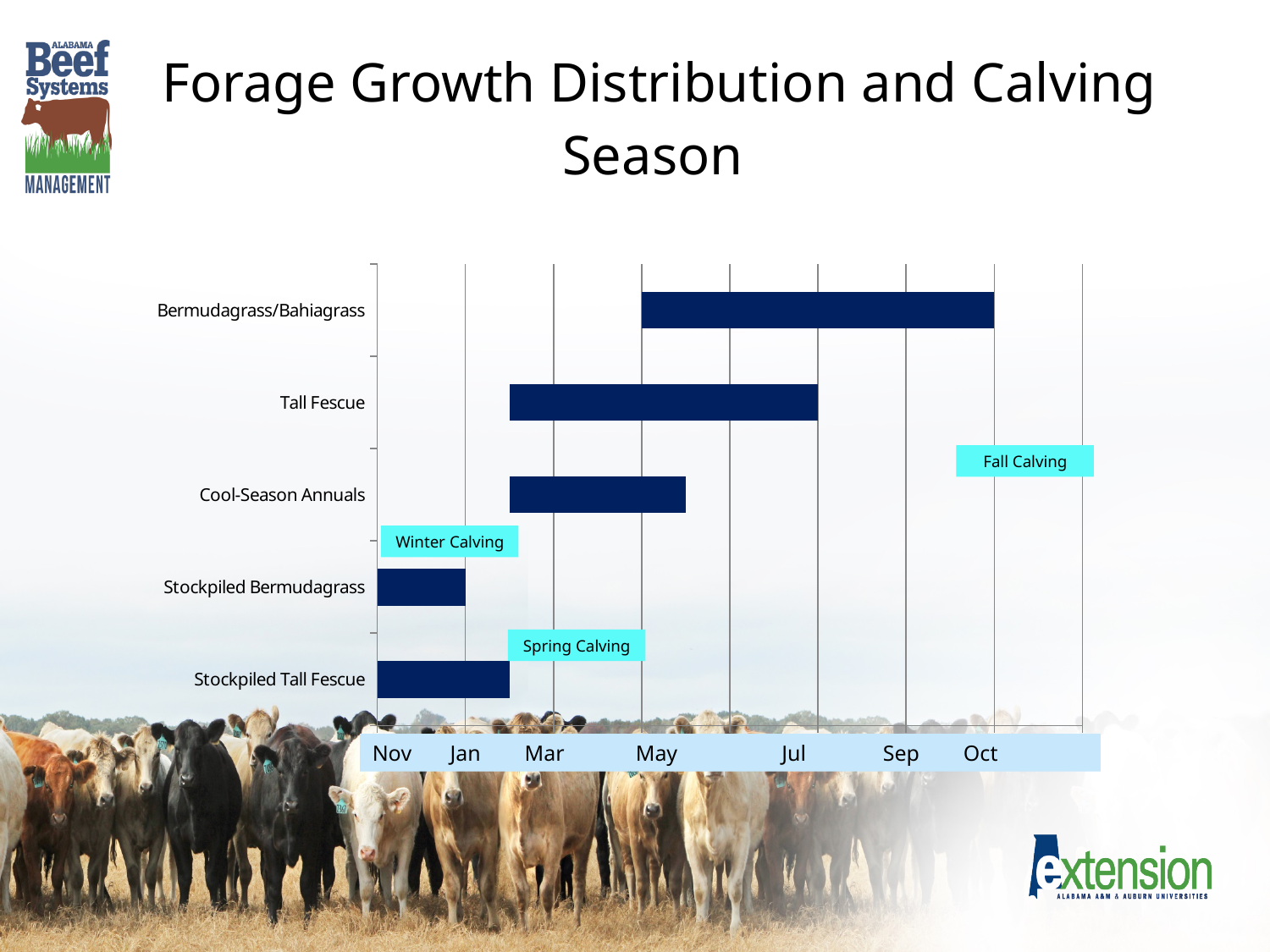
How many forage categories are listed on the vertical axis of the chart? 5 Which forage's growth bar begins furthest to the right along the x axis? Bermudagrass/Bahiagrass Which bar is longer, Tall Fescue or Cool-Season Annuals? Tall Fescue Which two forages have growth bars that start at the left edge of the chart (Nov)? Stockpiled Bermudagrass and Stockpiled Tall Fescue What is the title of the slide containing the chart? Forage Growth Distribution and Calving Season What is the last month label on the x axis of the chart? Oct Which bar is longer, Stockpiled Tall Fescue or Stockpiled Bermudagrass? Stockpiled Tall Fescue Which forage has the shortest growth bar in the chart? Stockpiled Bermudagrass What kind of chart is shown on the slide? Bar chart What are the three calving season labels shown on the chart? Winter Calving, Spring Calving, Fall Calving What is the first month label on the x axis of the chart? Nov Which forage has the longest growth bar in the chart? Bermudagrass/Bahiagrass